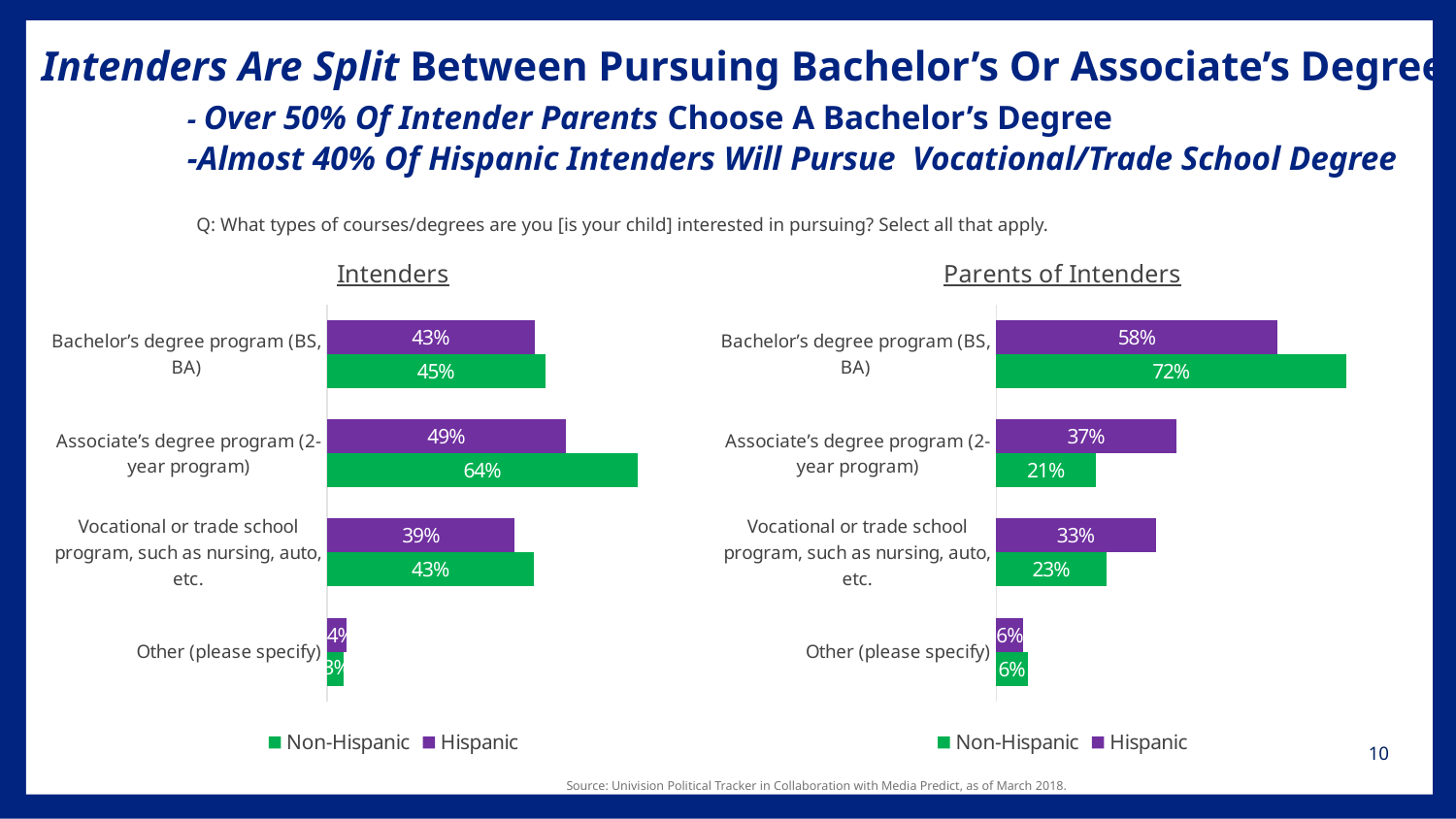
What type of chart is the Intenders chart? Bar chart In the Intenders chart, what is the difference between the Non-Hispanic and Hispanic values for Associate's degree program (2-year program)? 15% In the Parents of Intenders chart, what is the Hispanic value for Vocational or trade school program, such as nursing, auto, etc.? 33% In the Intenders chart, what is the Non-Hispanic value for Bachelor's degree program (BS, BA)? 45% In the Parents of Intenders chart, what is the Non-Hispanic value for Bachelor's degree program (BS, BA)? 72% In the Parents of Intenders chart, which category has the lowest Hispanic value? Other (please specify) In the Intenders chart, what is the Hispanic value for Associate's degree program (2-year program)? 49% In the Intenders chart, which category has the highest Non-Hispanic value? Associate's degree program (2-year program) How many categories are shown in the Intenders chart? 4 In the Parents of Intenders chart, what is the difference between the Non-Hispanic and Hispanic values for Bachelor's degree program (BS, BA)? 14% How many series does the legend of the Parents of Intenders chart list? 2 In the Parents of Intenders chart, which is larger for Associate's degree program (2-year program): the Hispanic value or the Non-Hispanic value? Hispanic